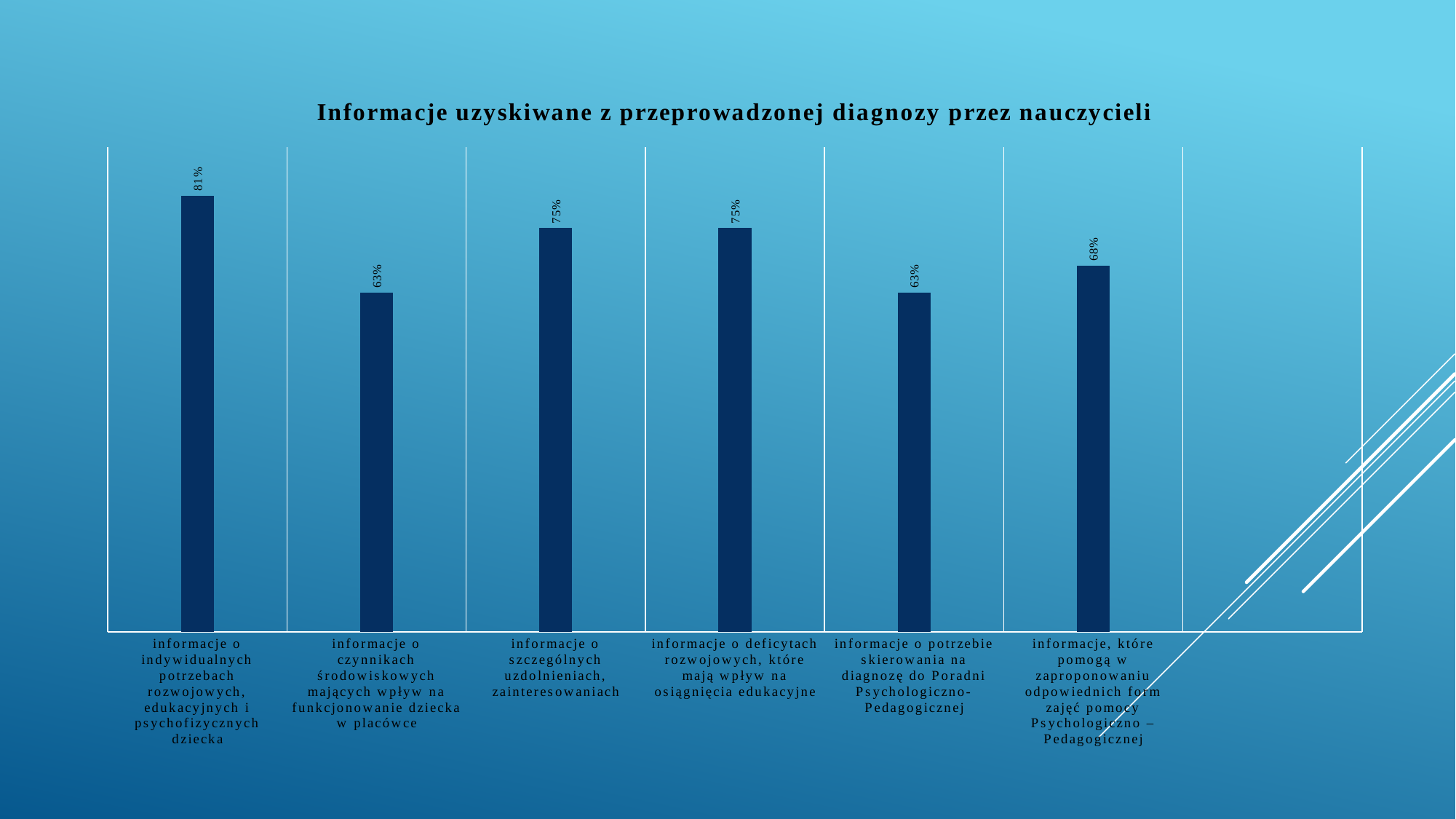
What is the value for "informacje, które pomogą w zaproponowaniu odpowiednich form zajęć pomocy Psychologiczno – Pedagogicznej"? 68% How many categories share the value 75%? 2 What is the value for "informacje o indywidualnych potrzebach rozwojowych, edukacyjnych i psychofizycznych dziecka"? 81% What is the title of the chart? Informacje uzyskiwane z przeprowadzonej diagnozy przez nauczycieli What is the value for "informacje o szczególnych uzdolnieniach, zainteresowaniach"? 75% Which category has the highest value? informacje o indywidualnych potrzebach rozwojowych, edukacyjnych i psychofizycznych dziecka Which is larger: the value for "informacje o szczególnych uzdolnieniach, zainteresowaniach" or the value for "informacje o czynnikach środowiskowych mających wpływ na funkcjonowanie dziecka w placówce"? informacje o szczególnych uzdolnieniach, zainteresowaniach How many categories are shown in the chart? 6 What is the difference between the value for "informacje o deficytach rozwojowych, które mają wpływ na osiągnięcia edukacyjne" and the value for "informacje, które pomogą w zaproponowaniu odpowiednich form zajęć pomocy Psychologiczno – Pedagogicznej"? 7% What is the value for "informacje o czynnikach środowiskowych mających wpływ na funkcjonowanie dziecka w placówce"? 63% What kind of chart is shown on the slide? bar chart What is the difference between the value for "informacje o indywidualnych potrzebach rozwojowych, edukacyjnych i psychofizycznych dziecka" and the value for "informacje o potrzebie skierowania na diagnozę do Poradni Psychologiczno-Pedagogicznej"? 18%